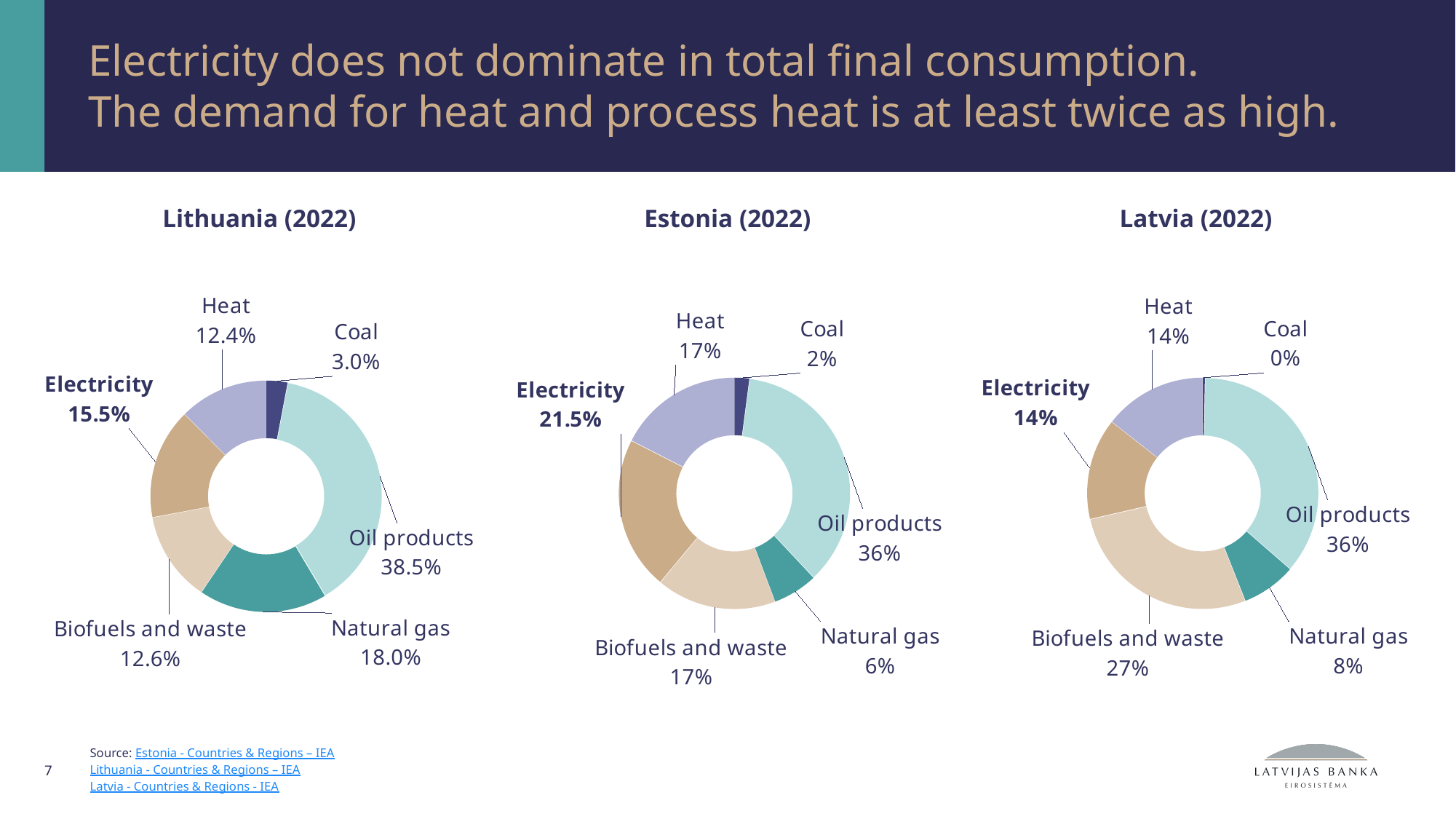
In the Lithuania (2022) chart, which category has the largest share? Oil products How many charts are shown on the slide? 3 In the Latvia (2022) chart, what share is Biofuels and waste? 27% In the Estonia (2022) chart, which is larger, Heat or Natural gas? Heat In the Estonia (2022) chart, what share is Electricity? 21.5% In the Latvia (2022) chart, which category has the smallest share? Coal In the Latvia (2022) chart, what is the difference between Oil products and Biofuels and waste? 9% How many categories does the Lithuania (2022) chart show? 6 In the Lithuania (2022) chart, what is the difference between the Natural gas share and the Electricity share? 2.5% In the Estonia (2022) chart, which category has the smallest share? Coal What type of chart is used for Estonia (2022)? Doughnut chart In the Lithuania (2022) chart, what share is Oil products? 38.5%